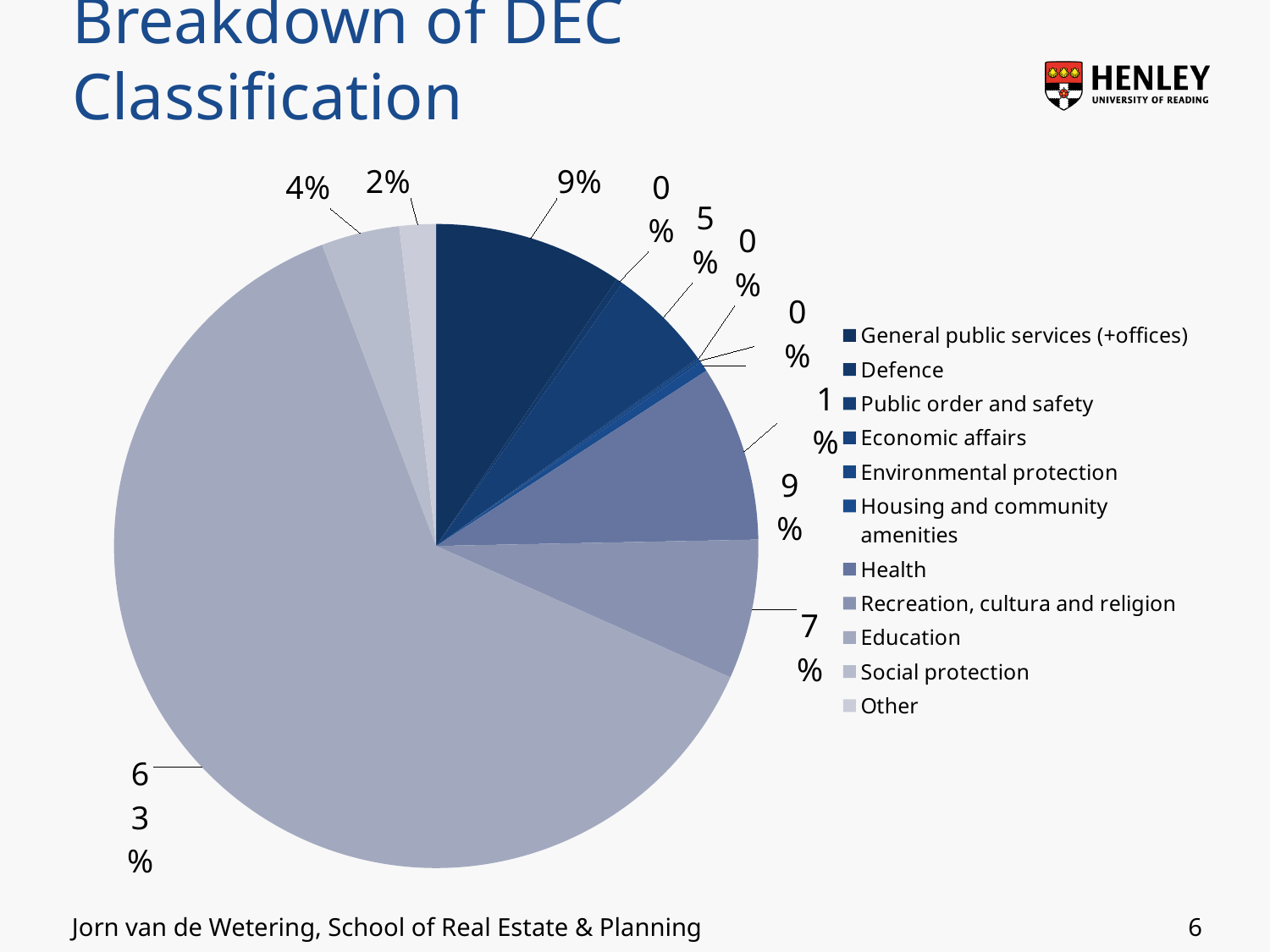
Which category has the largest slice of the pie? Education Which is larger, the share for Recreation, cultura and religion or the share for Social protection? Recreation, cultura and religion What percentage is shown for General public services (+offices)? 9% What share of the pie does Education account for? 63% What percentage is shown for Other? 2% What is the title of the slide's chart? Breakdown of DEC Classification What percentage is shown for Housing and community amenities? 1% How many categories does the legend of the pie chart list? 11 What is the difference in percentage points between Education and Health? 54 What percentage is shown for Public order and safety? 5% What percentage is shown for Social protection? 4% What type of chart is shown on the slide? pie chart